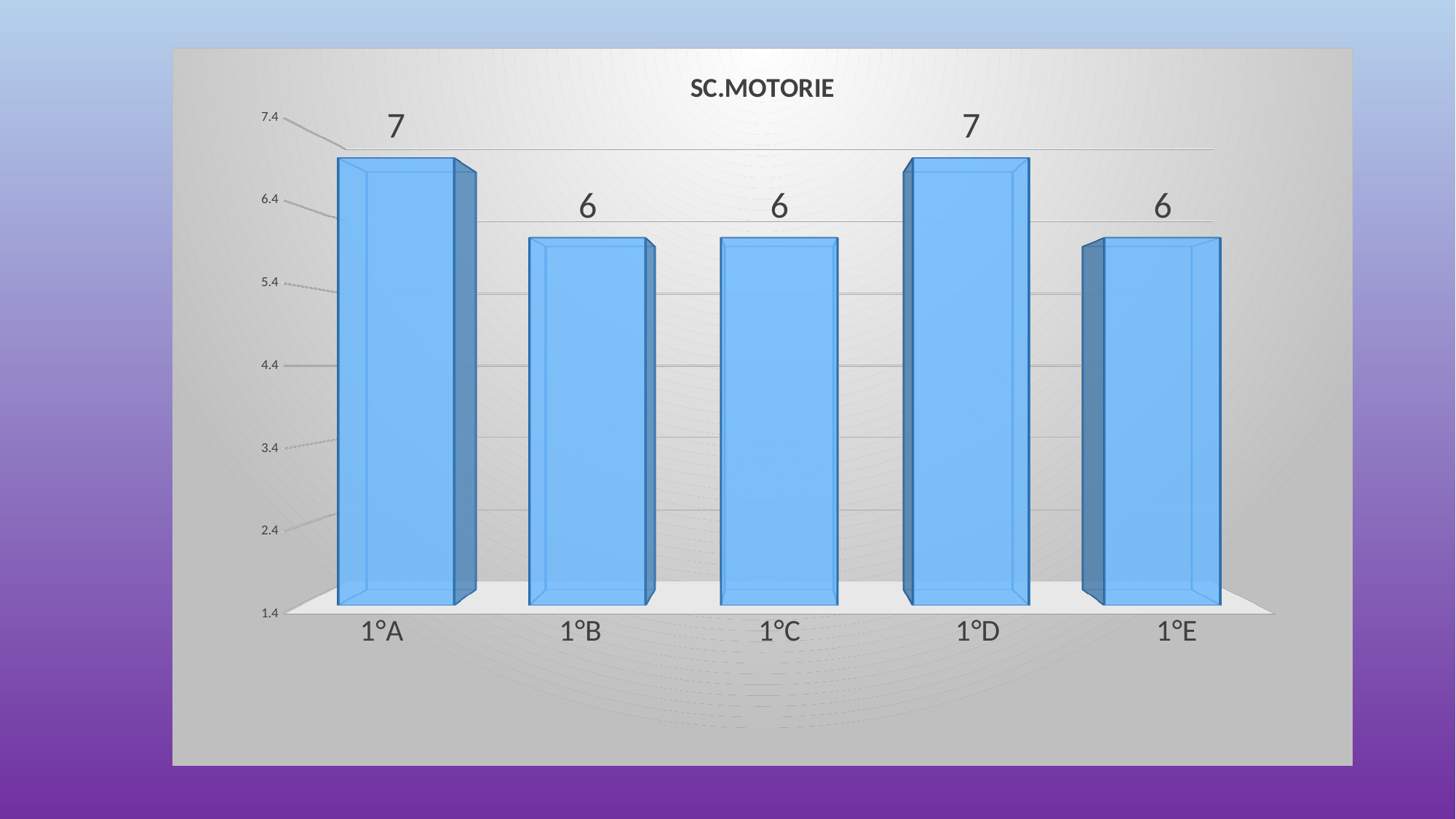
What kind of chart is shown on the slide? bar chart What is the difference between the values for 1°A and 1°B? 1 Is the value for 1°C greater or less than 4.4? greater What is the difference between the values for 1°D and 1°E? 1 What is the value for 1°E? 6 What is the title of the chart? SC.MOTORIE How many categories are shown on the x axis? 5 Which is larger, the value for 1°D or the value for 1°C? 1°D What is the value for 1°D? 7 What colour are the bars in the chart? blue What is the value for 1°B? 6 What is the value for 1°A? 7